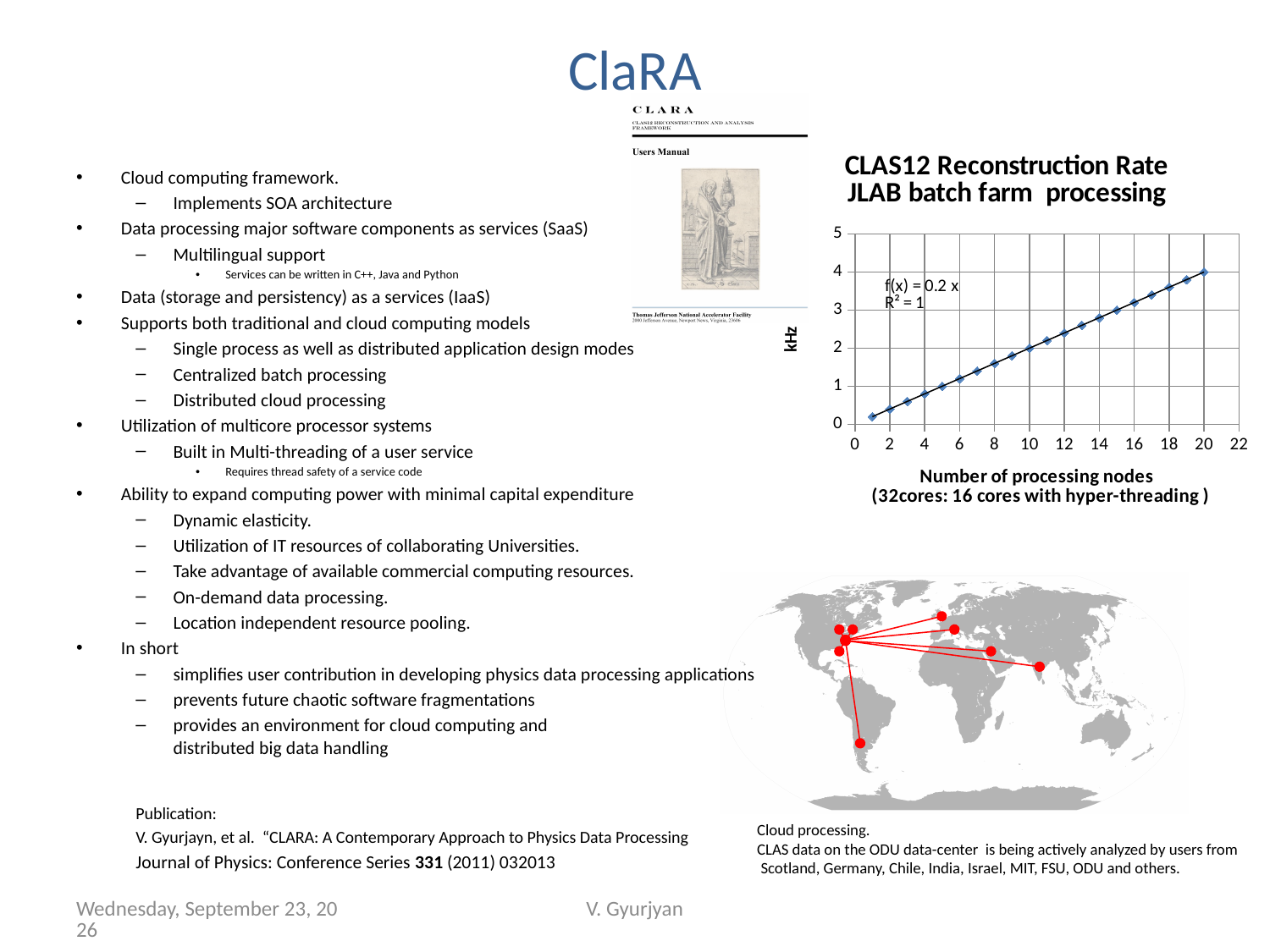
In the CLAS12 Reconstruction Rate chart, which number of processing nodes gives the highest reconstruction rate? 20 In the CLAS12 Reconstruction Rate chart, is the value at 10 processing nodes greater or less than 3? less What is the trendline equation printed on the CLAS12 Reconstruction Rate chart? f(x) = 0.2 x What kind of chart is shown under the title "CLAS12 Reconstruction Rate JLAB batch farm processing"? scatter chart What R² value is printed on the CLAS12 Reconstruction Rate chart? R² = 1 In the CLAS12 Reconstruction Rate chart, what is the reconstruction rate in kHz at 20 processing nodes? 4 In the CLAS12 Reconstruction Rate chart, is the value at 5 processing nodes greater or less than 2? less In the CLAS12 Reconstruction Rate chart, what is the reconstruction rate in kHz at 10 processing nodes? 2 In the CLAS12 Reconstruction Rate chart, is the value at 20 processing nodes greater or less than 3? greater In the CLAS12 Reconstruction Rate chart, which is larger: the value at 18 processing nodes or the value at 8 processing nodes? 18 processing nodes In the CLAS12 Reconstruction Rate chart, do the values rise or fall as the number of processing nodes increases? rise